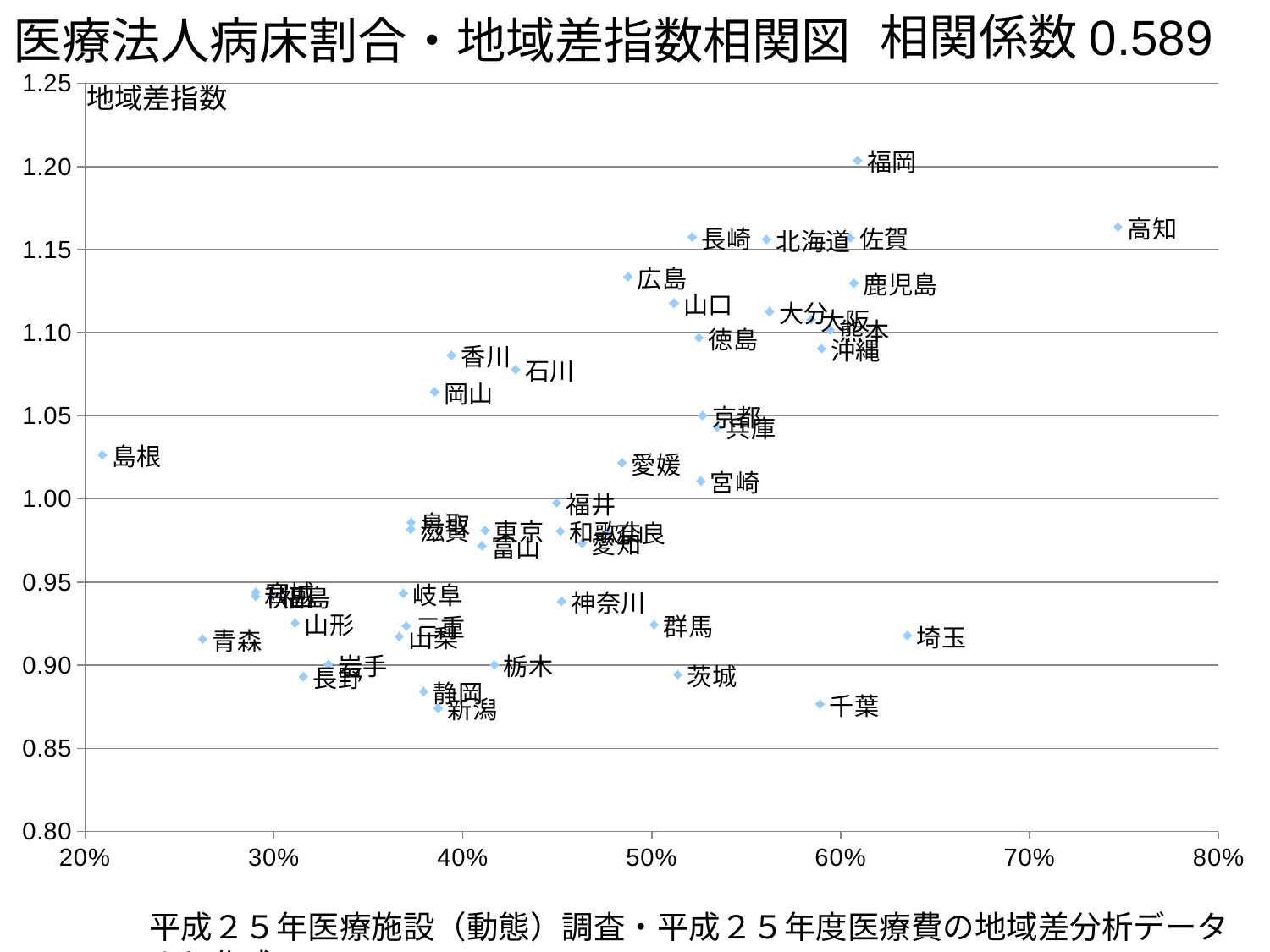
Which prefecture has the highest 地域差指数 value in the chart? 福岡 Which has the higher 地域差指数 value, 福岡 or 高知? 福岡 As the horizontal-axis value (医療法人病床割合) increases, does the 地域差指数 generally rise or fall? rise What kind of chart is shown on the slide? scatter chart Which prefecture has the highest value on the horizontal axis (医療法人病床割合)? 高知 What correlation coefficient (相関係数) is stated in the chart title? 0.589 Is the horizontal-axis value for 高知 greater or less than 70%? greater Which prefecture has the lowest value on the horizontal axis (医療法人病床割合)? 島根 What label is shown for the vertical axis of the chart? 地域差指数 Is the 地域差指数 value for 千葉 greater or less than 0.90? less Is the 地域差指数 value for 福岡 greater or less than 1.15? greater